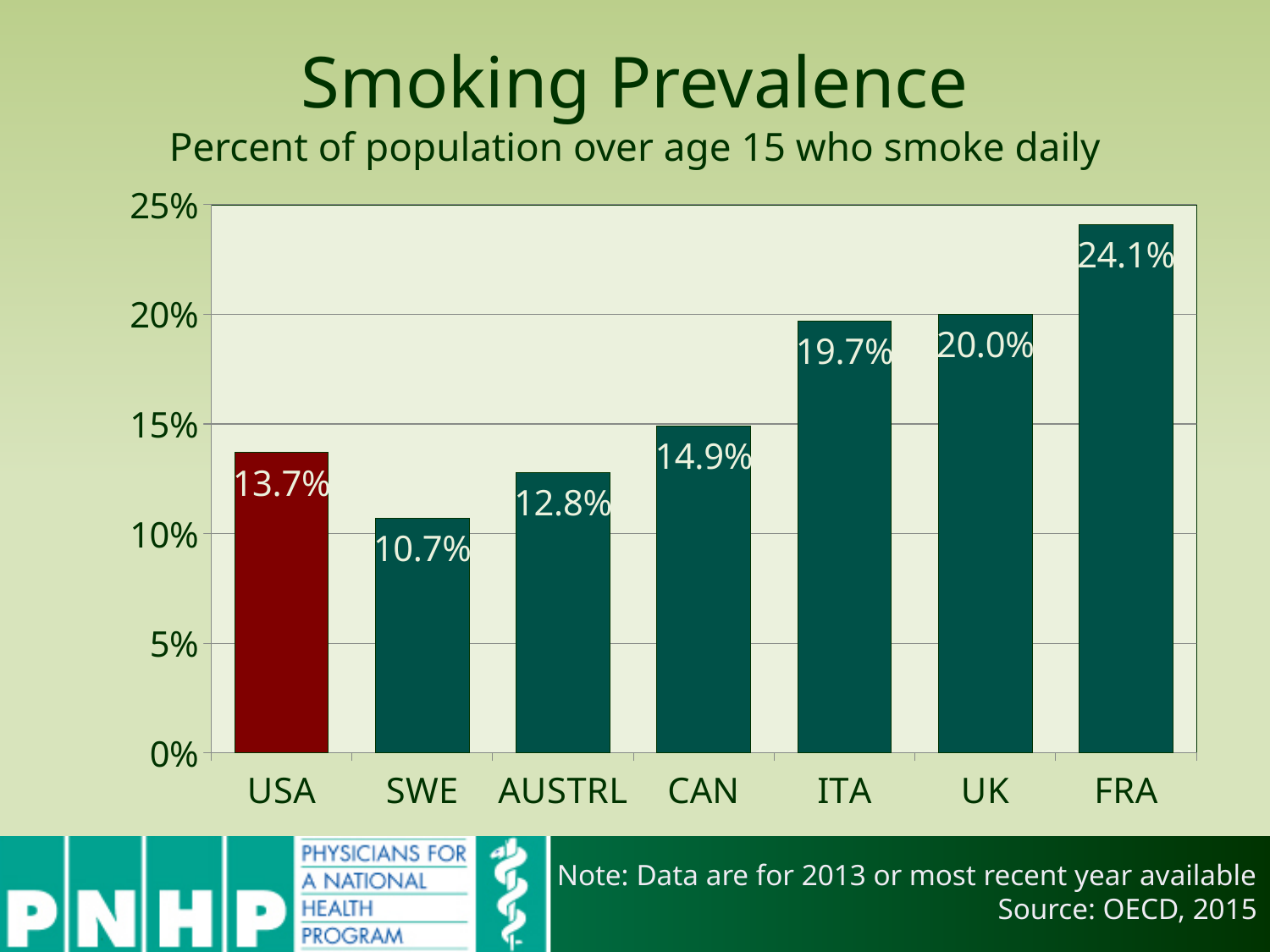
How many countries are shown in the chart? 7 What is the smoking prevalence for the USA? 13.7% What is the difference in smoking prevalence between FRA and the USA? 10.4% What kind of chart is shown on the slide? Bar chart Which has a higher smoking prevalence, AUSTRL or CAN? CAN What is the smoking prevalence for FRA? 24.1% Which country's bar is coloured differently (red) from the others? USA What is the difference in smoking prevalence between the UK and ITA? 0.3% What is the smoking prevalence for CAN? 14.9% Is the value for ITA greater or less than 15%? greater Which country has the lowest smoking prevalence? SWE Which country has the highest smoking prevalence? FRA